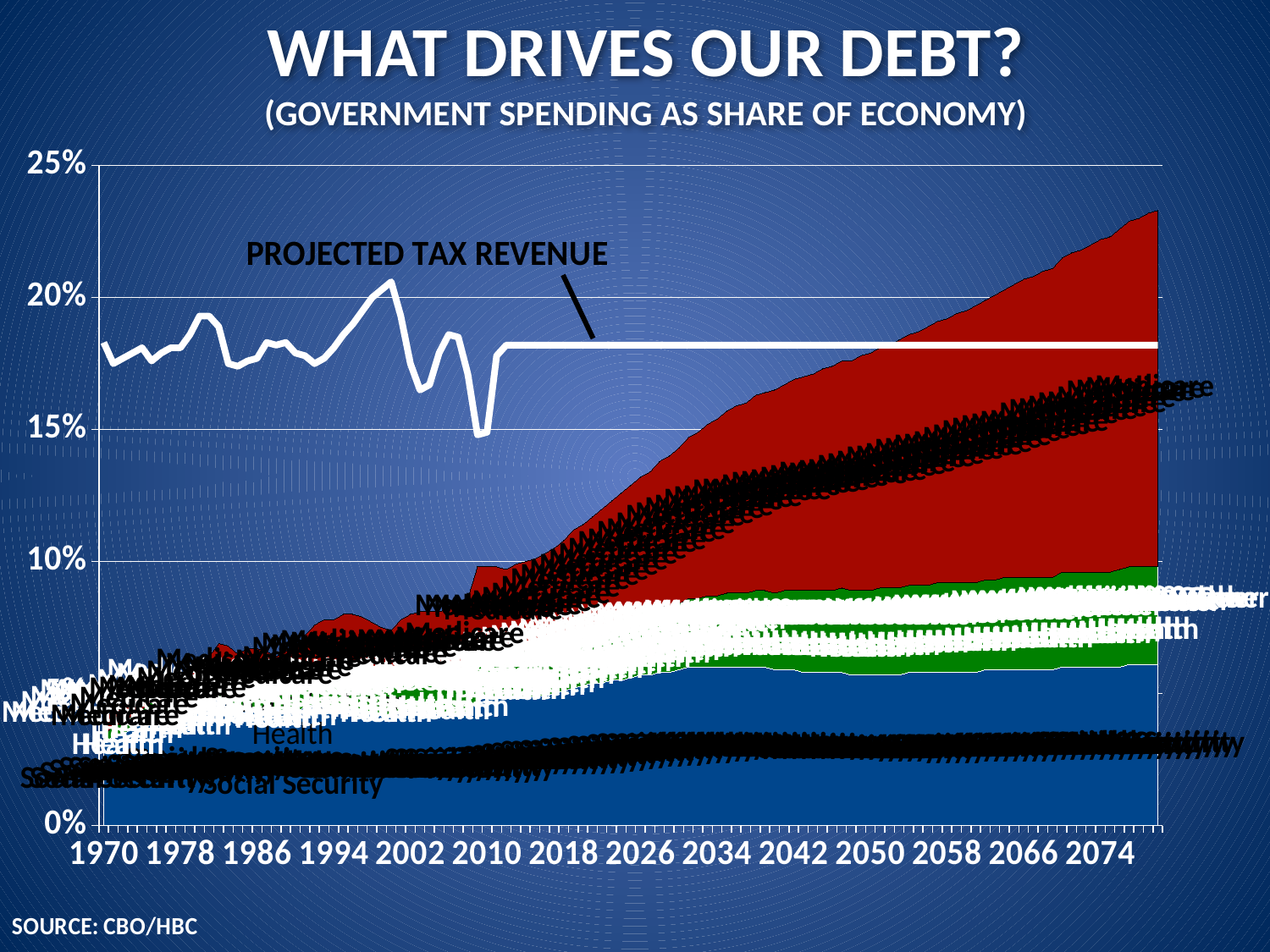
Is the Social Security share in 2074 greater or less than 10%? less Is the projected tax revenue line in 2050 greater or less than 20%? less What is the highest value shown on the vertical axis? 25% Is the projected tax revenue line in 2050 greater or less than 15%? greater Which category forms the bottom (blue) layer of the stacked area? Social Security What kind of chart is shown on the slide? Stacked area chart with a line What is the last year labelled on the horizontal axis? 2074 After about 2012, does the projected tax revenue line rise, fall, or stay flat? stay flat Does total government spending as a share of the economy rise or fall from 2018 to 2074? rise What is the title of the chart? WHAT DRIVES OUR DEBT?